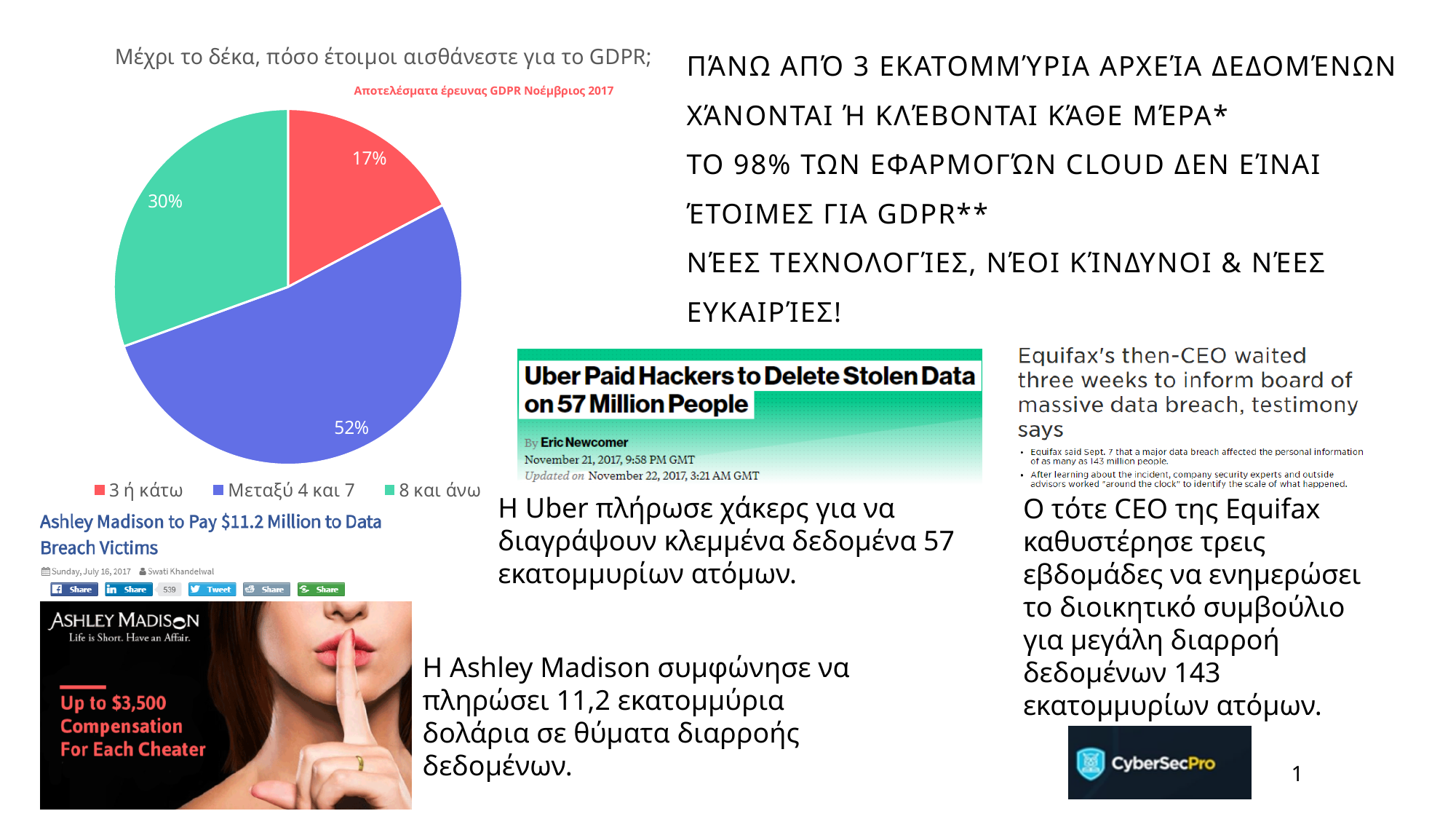
What is the difference in percentage points between the "Μεταξύ 4 και 7" slice and the "8 και άνω" slice? 22 What share of the pie does the "8 και άνω" slice represent? 30% Which is larger: the "8 και άνω" slice or the "3 ή κάτω" slice? 8 και άνω How many categories does the pie chart have? 3 Which category has the smallest slice of the pie? 3 ή κάτω What is the difference in percentage points between the "8 και άνω" slice and the "3 ή κάτω" slice? 13 What colour is the "Μεταξύ 4 και 7" slice in the pie chart? blue What share of the pie does the "Μεταξύ 4 και 7" slice represent? 52% What is the title of the pie chart? Μέχρι το δέκα, πόσο έτοιμοι αισθάνεστε για το GDPR; Which category has the largest slice of the pie? Μεταξύ 4 και 7 What kind of chart is shown on the slide? pie chart What share of the pie does the "3 ή κάτω" slice represent? 17%